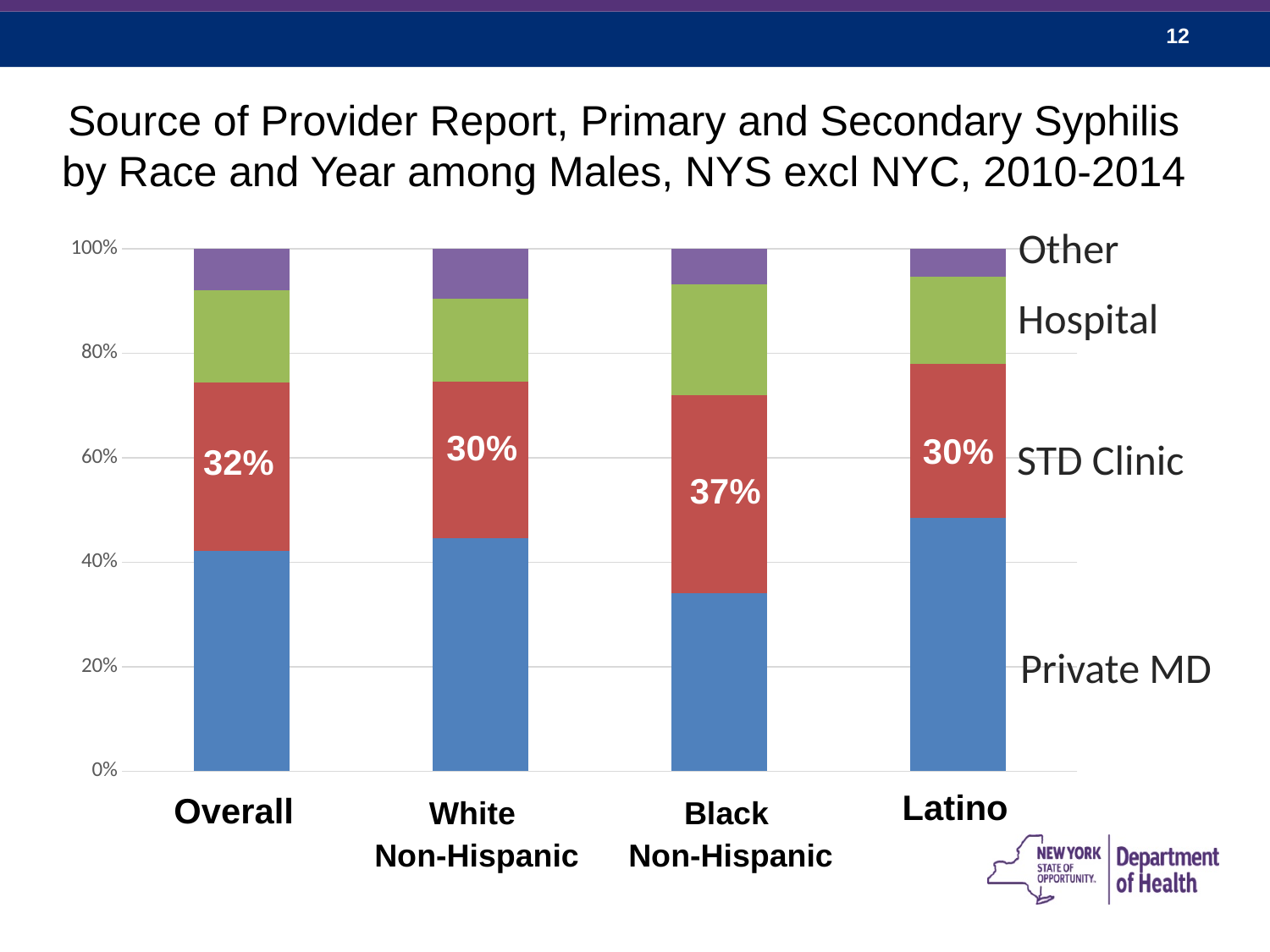
How many race categories are shown on the x axis? 4 Is the Private MD value for Black Non-Hispanic greater or less than 40%? less What is the STD Clinic percentage for the Overall group? 32% Which has a larger STD Clinic percentage, Overall or White Non-Hispanic? Overall What is the STD Clinic percentage for White Non-Hispanic males? 30% What is the STD Clinic percentage for Black Non-Hispanic males? 37% What is the difference in STD Clinic percentage between Black Non-Hispanic and Overall? 5 percentage points What is the STD Clinic percentage for Latino males? 30% Which race group has the lowest Private MD share? Black Non-Hispanic Is the Private MD value for Latino greater or less than 40%? greater Which race group has the highest STD Clinic percentage? Black Non-Hispanic How many provider source series are shown in the stacked bars? 4